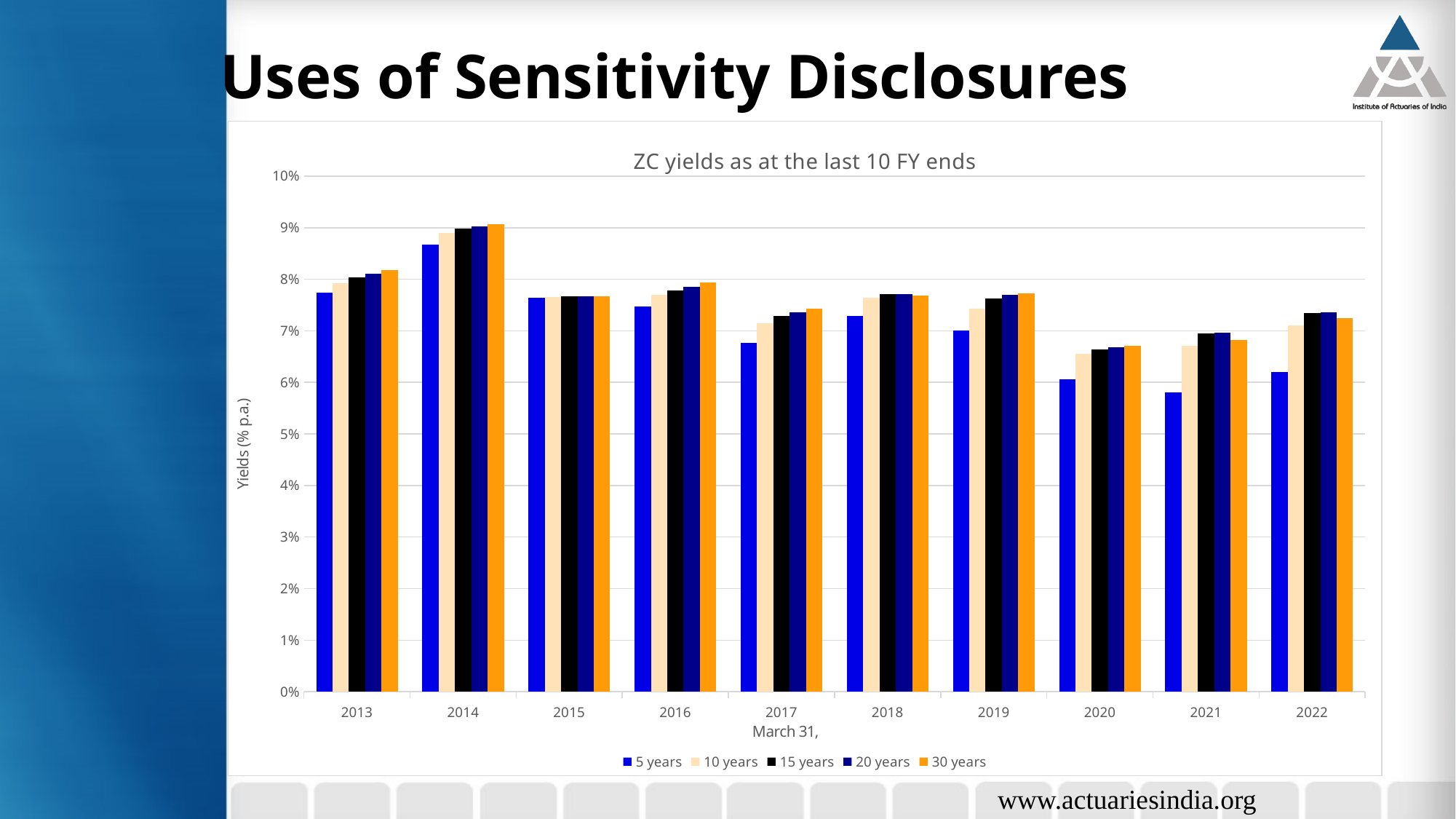
What is the label of the vertical axis? Yields (% p.a.) What kind of chart is shown on the slide? bar chart Is the 5 years yield for 2014 greater or less than 8%? greater Is the 30 years yield for 2013 greater or less than 8%? greater In which year is the 5 years yield highest? 2014 Is the 5 years yield for 2021 greater or less than 6%? less Which is larger, the 30 years yield for 2016 or for 2017? 2016 In which year is the 5 years yield lowest? 2021 What is the title of the chart? ZC yields as at the last 10 FY ends How many years are shown on the x axis? 10 In which year is the 30 years yield highest? 2014 How many series does the legend list? 5